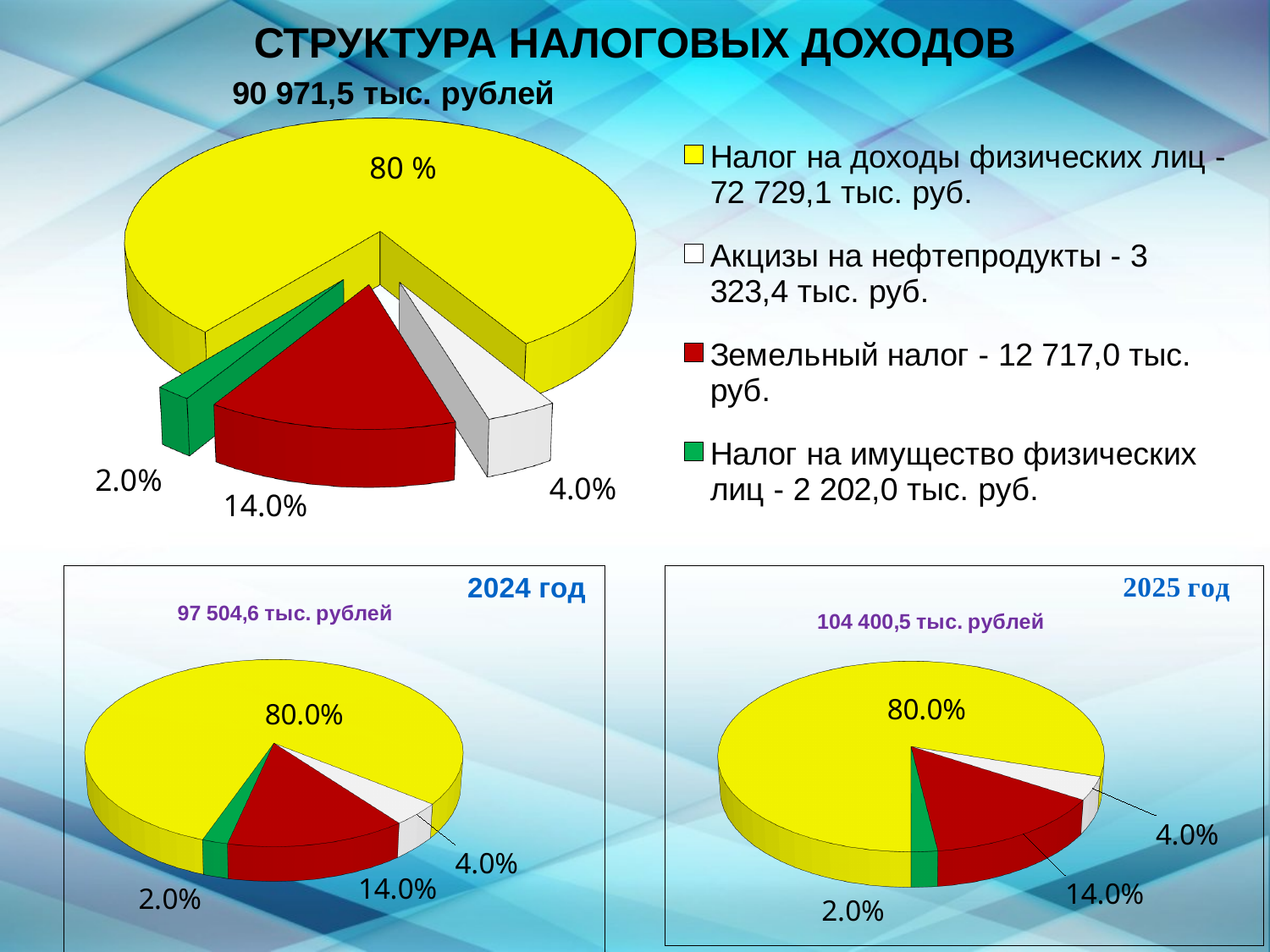
What total amount is shown above the 2024 год pie chart? 97 504,6 тыс. рублей According to the legend of the top chart, what is the value for Земельный налог? 12 717,0 тыс. руб. In the 2025 год pie chart, what share is shown for the white slice? 4.0% In the top pie chart, which category has the largest share? Налог на доходы физических лиц According to the legend of the top chart, what is the value for Акцизы на нефтепродукты? 3 323,4 тыс. руб. In the top pie chart, which category has the smallest share? Налог на имущество физических лиц How many entries does the legend of the top chart list? 4 In the top pie chart, what share is shown for the red slice (Земельный налог)? 14.0% In the top pie chart, what share is shown for the yellow slice (Налог на доходы физических лиц)? 80 % In the top pie chart, which is larger: the share for Земельный налог or the share for Акцизы на нефтепродукты? Земельный налог What kind of chart is the top chart on the slide? pie chart